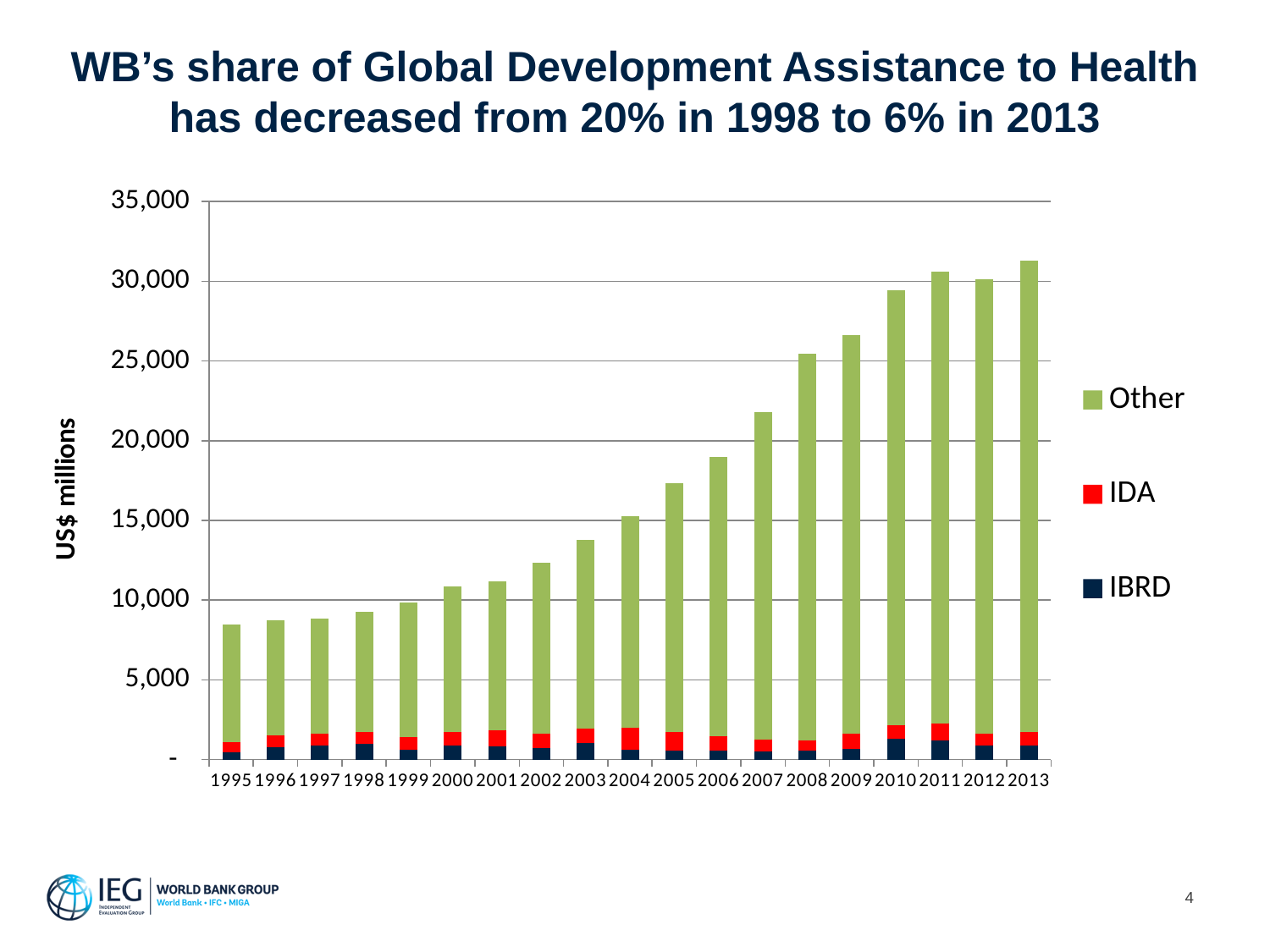
Is the total value of the bar for 1995 greater or less than 10,000? less What kind of chart is shown on the slide? Stacked bar chart How many years are shown along the x axis of the chart? 19 Is the total value of the bar for 2013 greater or less than 30,000? greater Do the total bar heights generally rise or fall from 1995 to 2013? rise How many series does the chart's legend list? 3 Is the total value of the bar for 1998 greater or less than 10,000? less What are the three series listed in the chart's legend? Other, IDA, IBRD What is the label on the vertical axis of the chart? US$ millions Which year has the taller total bar, 2007 or 2003? 2007